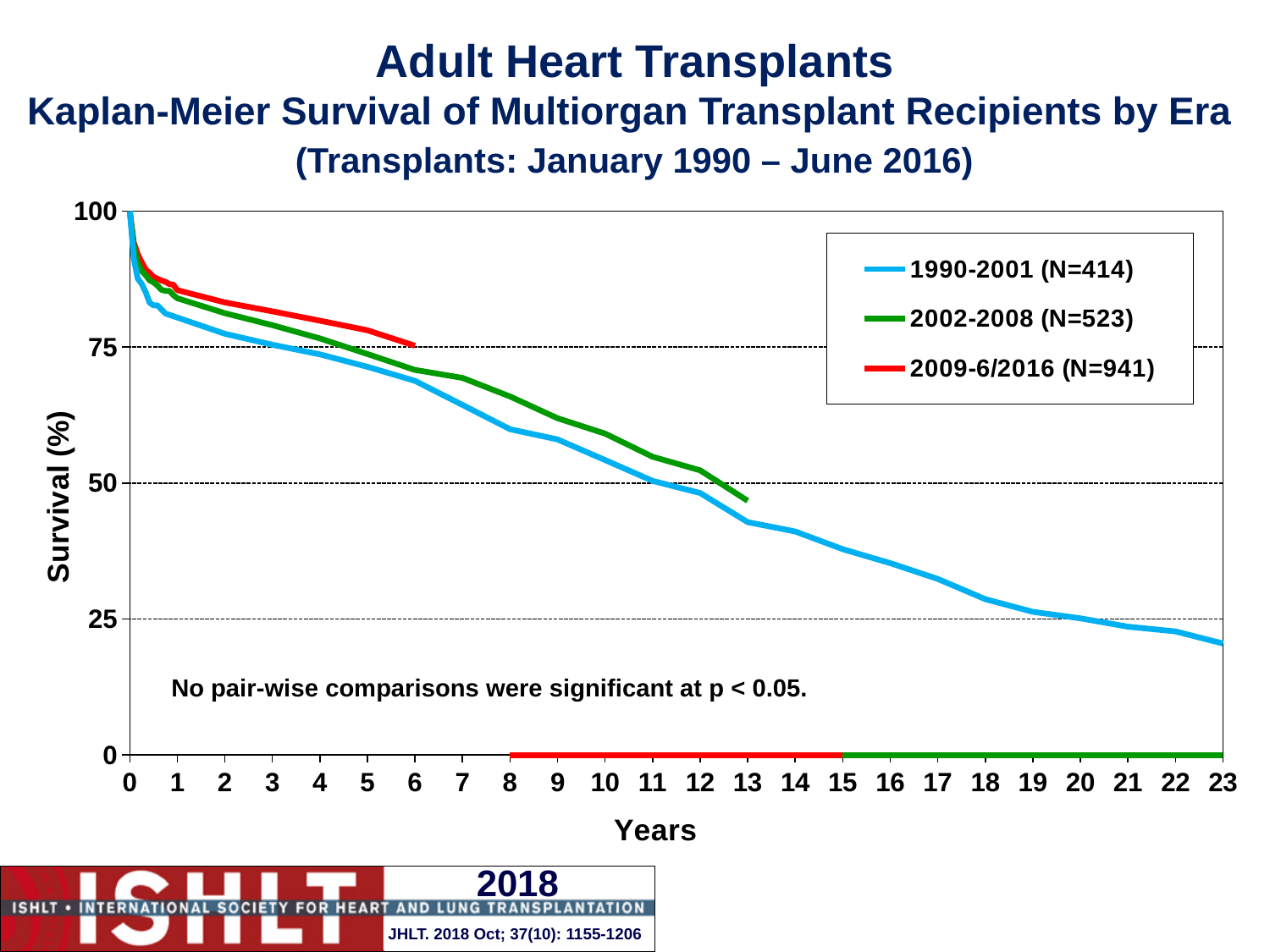
At 5 years, which era has higher survival: 1990-2001 or 2009-6/2016? 2009-6/2016 How many series does the legend list? 3 Do the survival curves rise or fall as years increase? Fall Is the survival for the 1990-2001 era at 5 years greater or less than 75? less What is the N for the 2002-2008 era shown in the legend? 523 Which era's curve extends the furthest along the x axis? 1990-2001 Is the survival for the 1990-2001 era at 23 years greater or less than 25? less Is the survival for the 1990-2001 era at 15 years greater or less than 50? less What kind of chart is shown on the slide? Line chart Which era has the largest number of recipients (N) according to the legend? 2009-6/2016 (N=941)